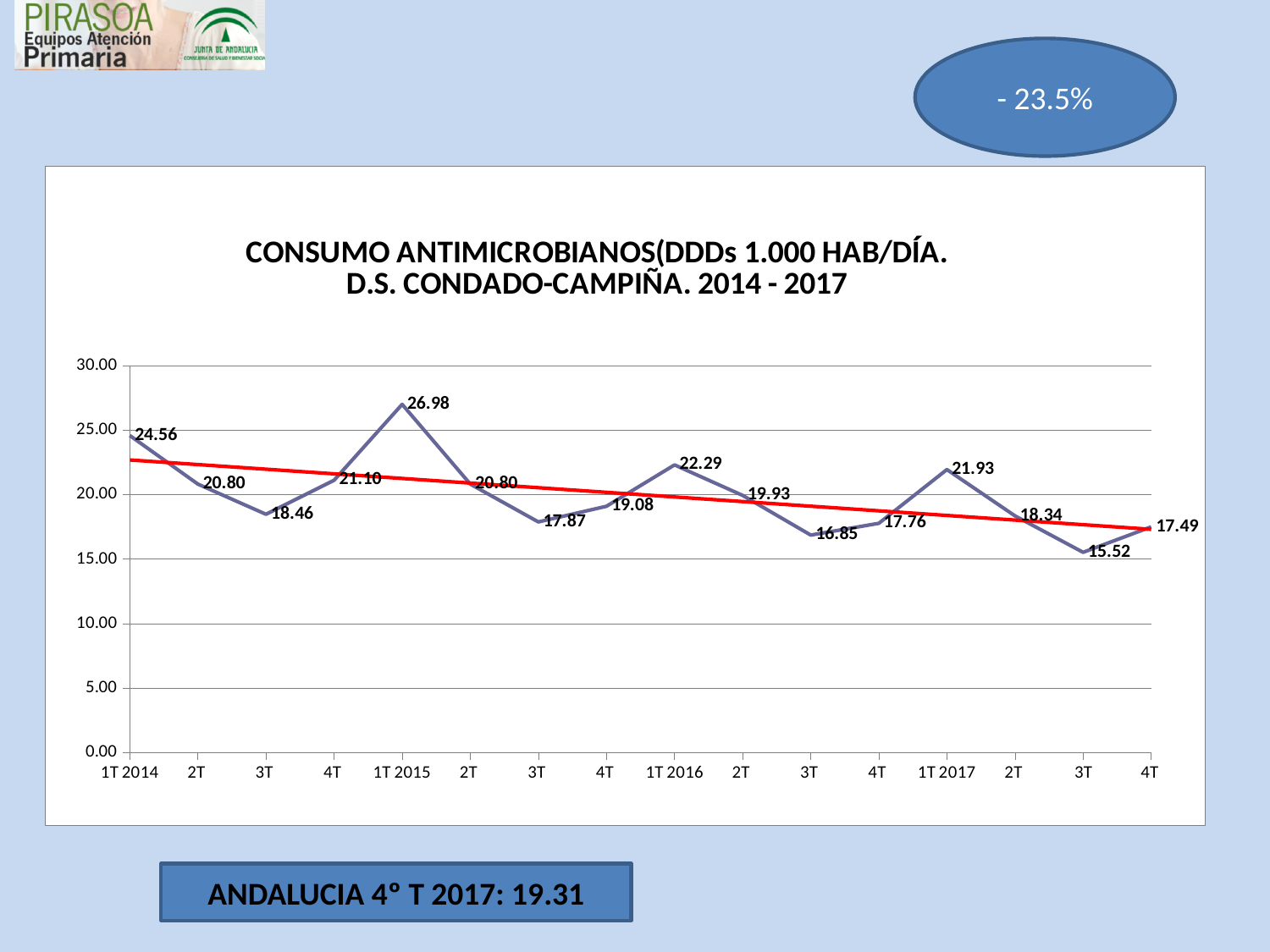
What type of chart is shown on the slide? Line chart Does the overall trend of the values from 1T 2014 to 4T 2017 rise or fall? Fall What is the value for 1T 2015? 26.98 What is the difference between the values for 1T 2015 and 3T 2017? 11.46 Which quarter has the lowest value? 3T 2017 Which quarter has the highest value? 1T 2015 How many quarterly data points are plotted on the chart? 16 What is the value for 1T 2014? 24.56 What is the value for 3T 2016? 16.85 What is the value for 4T 2017? 17.49 Which is larger, the value for 1T 2016 or the value for 1T 2017? 1T 2016 What is the title of the chart? CONSUMO ANTIMICROBIANOS(DDDs 1.000 HAB/DÍA. D.S. CONDADO-CAMPIÑA. 2014 - 2017